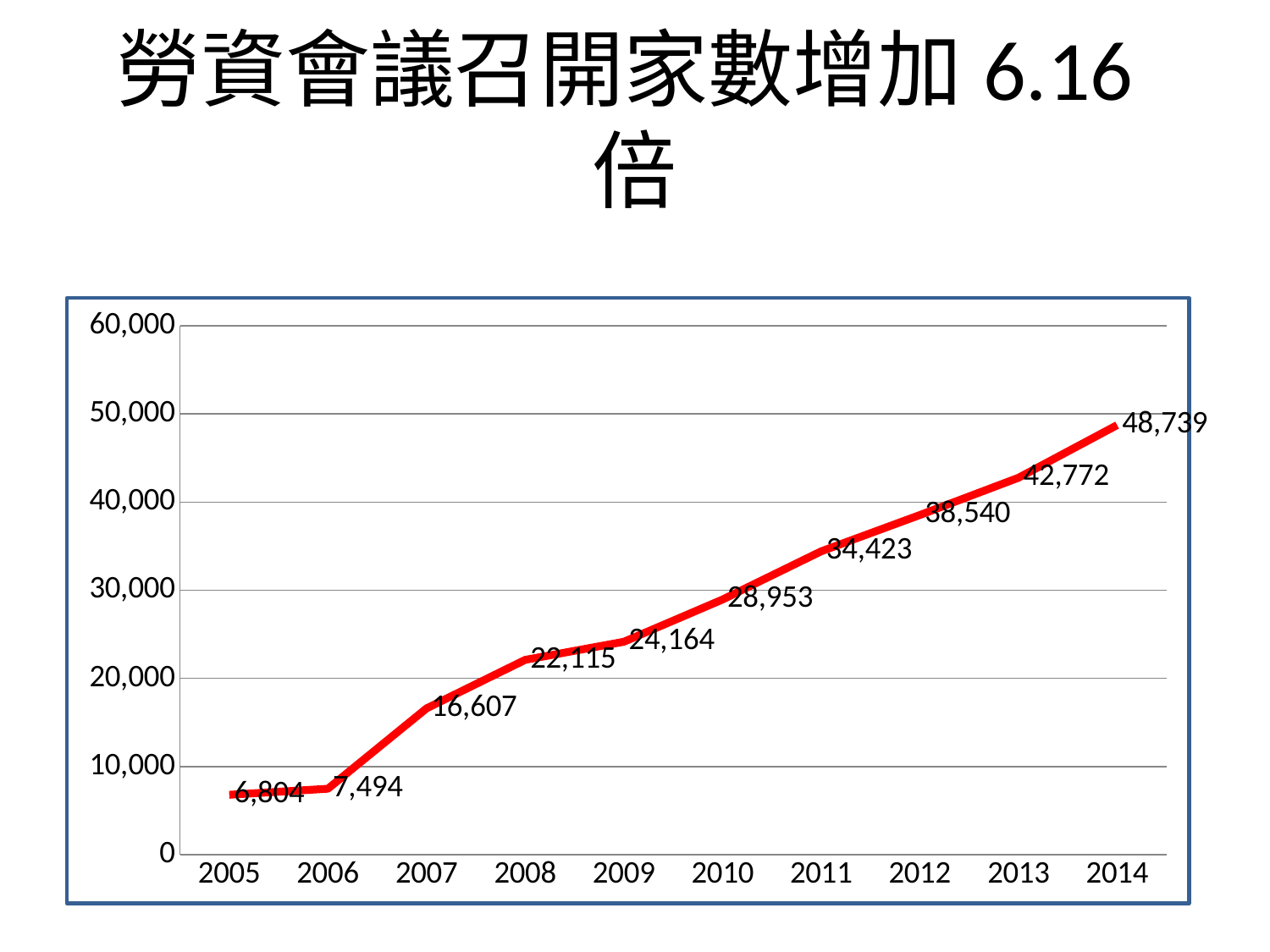
What is the difference between the values for 2014 and 2005? 41,935 What is the value for 2005? 6,804 Which is larger, the value for 2009 or the value for 2011? 2011 How many years are plotted on the x axis? 10 Is the value for 2012 greater or less than 30,000? greater What is the difference between the values for 2007 and 2006? 9,113 What is the value for 2014? 48,739 What is the value for 2010? 28,953 Do the values rise or fall from 2005 to 2014? rise What kind of chart is shown on the slide? line chart Which year has the lowest value? 2005 Which year has the highest value? 2014